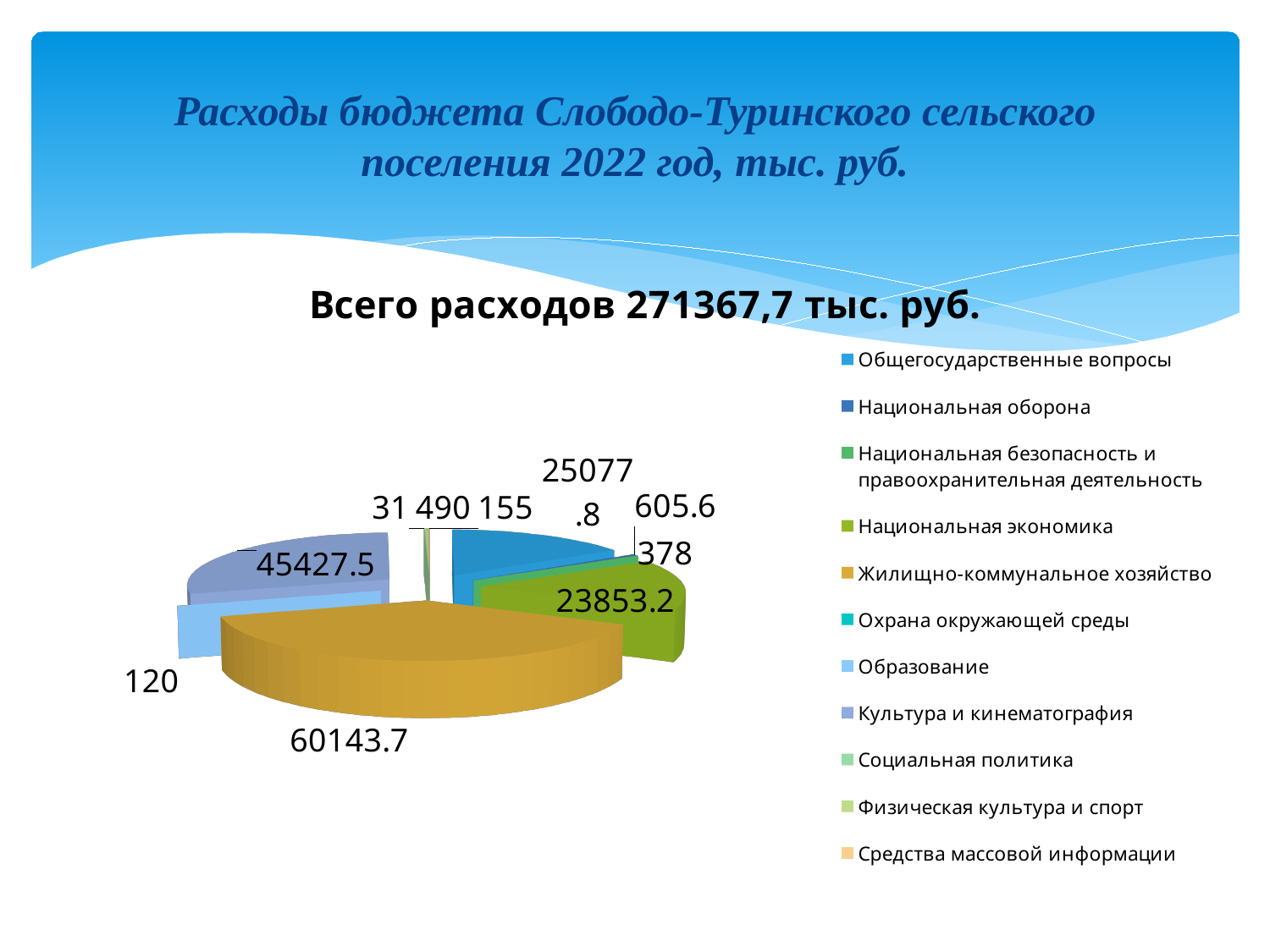
What is the value of the Национальная экономика slice? 23853.2 What is the value of the Жилищно-коммунальное хозяйство slice? 60143.7 How many categories does the legend of the pie chart list? 11 Which is larger, the Жилищно-коммунальное хозяйство slice or the Национальная экономика slice? Жилищно-коммунальное хозяйство What is the value of the Общегосударственные вопросы slice? 25077.8 What is the difference between the Общегосударственные вопросы value (25077.8) and the Национальная экономика value (23853.2)? 1224.6 What total expenditure is stated above the pie chart? 271367,7 тыс. руб. Which category is listed first in the legend of the pie chart? Общегосударственные вопросы Which is larger, the Общегосударственные вопросы slice or the Национальная экономика slice? Общегосударственные вопросы What kind of chart is shown on the slide? pie chart What is the difference between the Жилищно-коммунальное хозяйство value (60143.7) and the Национальная экономика value (23853.2)? 36290.5